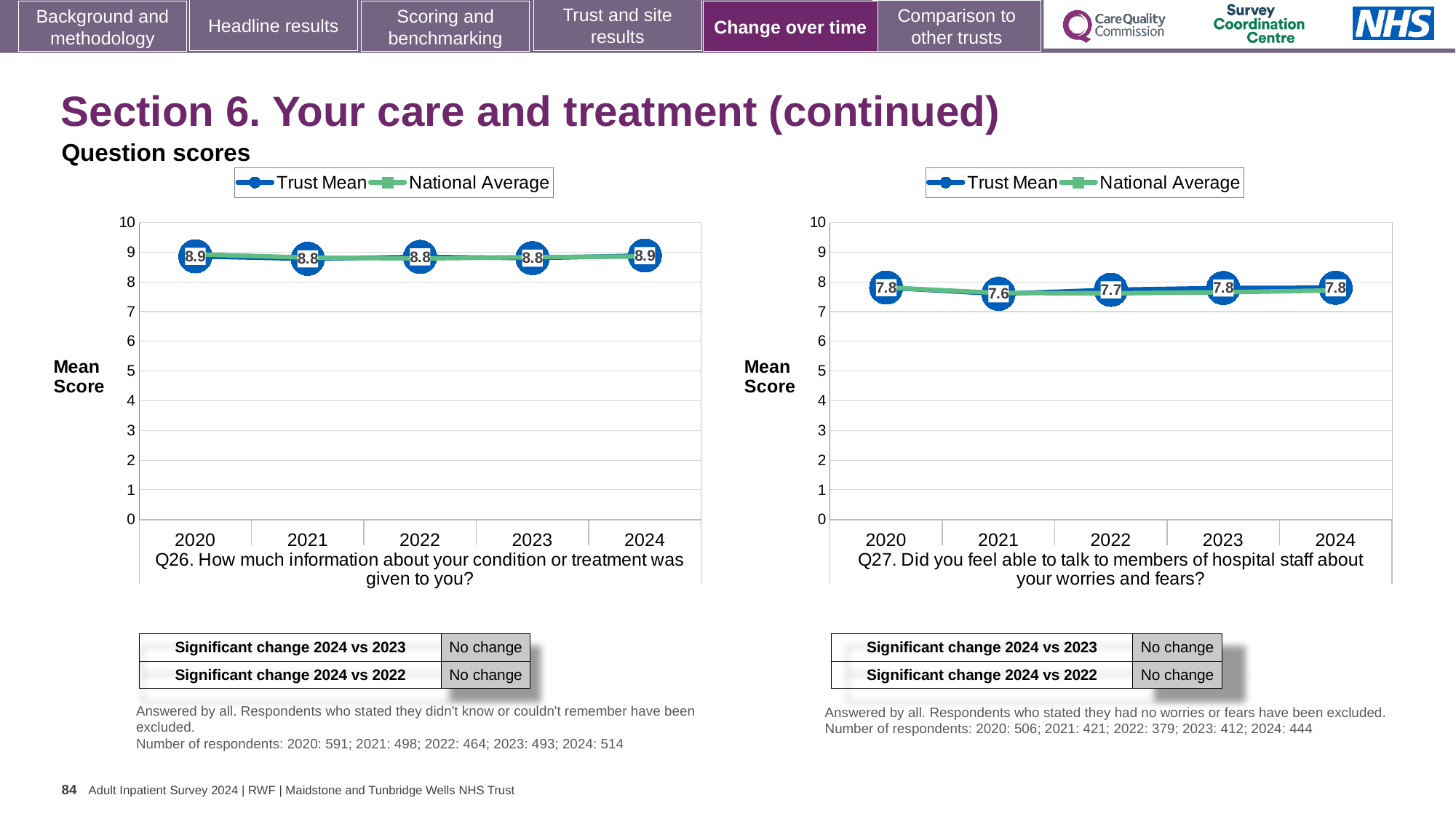
In the Q27 chart (right), what is the Trust Mean score for 2021? 7.6 In the Q26 chart (left), what is the Trust Mean score for 2022? 8.8 In the Q27 chart (right), what is the Trust Mean score for 2024? 7.8 What kind of chart is the Q26 chart (left)? Line chart In the Q27 chart (right), is the Trust Mean score for 2020 greater or less than 7? greater In the Q27 chart (right), which year has the lowest Trust Mean score? 2021 In the Q26 chart (left), is the Trust Mean score for 2023 greater or less than 9? less In the Q26 chart (left), what is the Trust Mean score for 2020? 8.9 In the Q27 chart (right), what is the difference between the Trust Mean scores for 2024 and 2021? 0.2 How many series does the legend of the Q27 chart (right) list? 2 What are the two series named in the legend of the Q26 chart (left)? Trust Mean and National Average In the Q26 chart (left), how many years are plotted on the x axis? 5